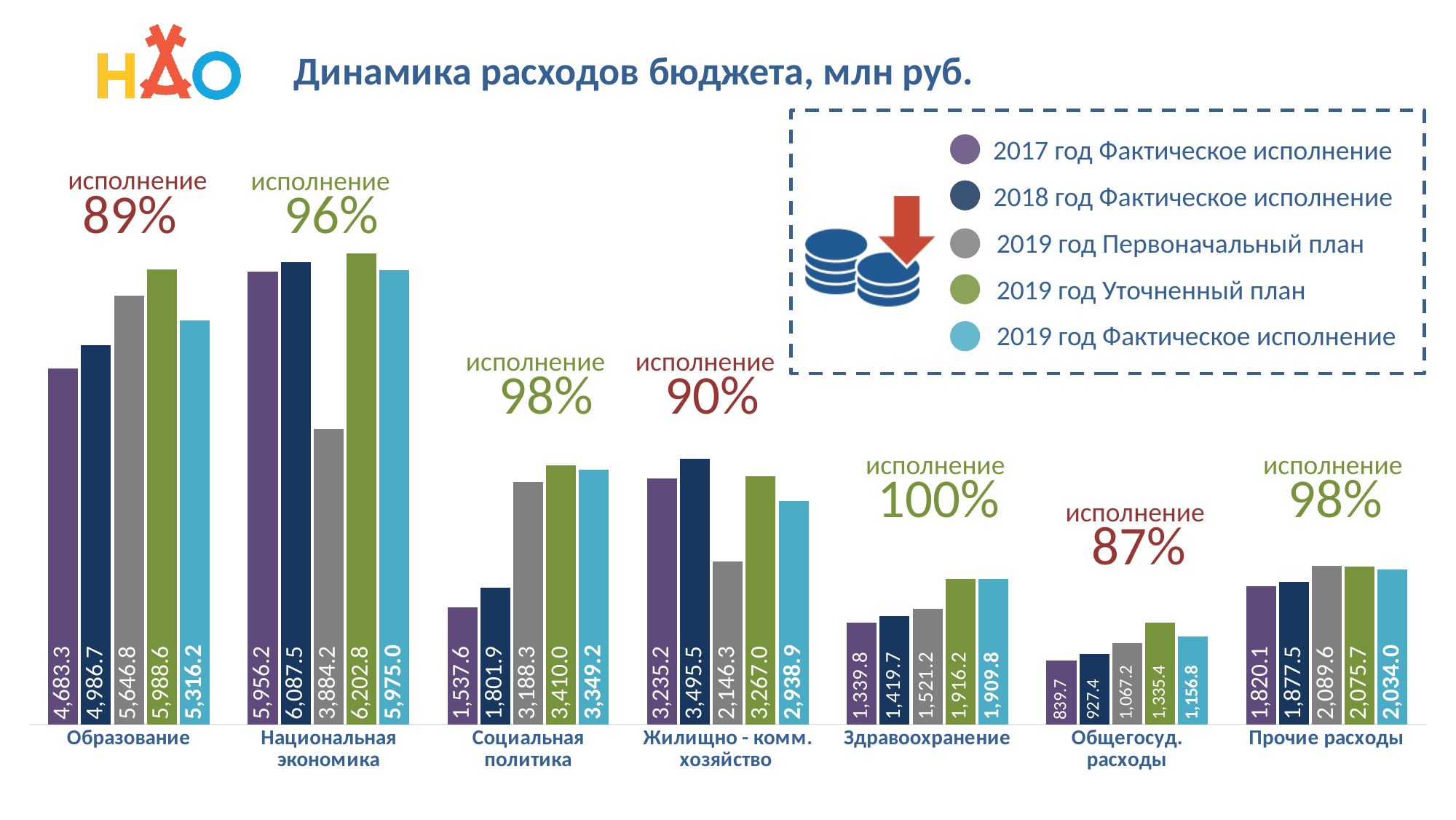
How many categories are shown on the x axis? 7 What is the title of the chart? Динамика расходов бюджета, млн руб. What kind of chart is shown on the slide? Bar chart What is the 2017 год Фактическое исполнение value for Национальная экономика? 5,956.2 What is the difference between the 2019 год Уточненный план and 2019 год Фактическое исполнение values for Образование? 672.4 Which category has the highest 2019 год Уточненный план value? Национальная экономика Which is larger for Жилищно - комм. хозяйство: the 2018 год Фактическое исполнение value or the 2019 год Фактическое исполнение value? 2018 год Фактическое исполнение What is the 2019 год Фактическое исполнение value for Образование? 5,316.2 Which category has the lowest 2017 год Фактическое исполнение value? Общегосуд. расходы How many series does the legend list? 5 What execution percentage (исполнение) is shown above Общегосуд. расходы? 87% What is the 2019 год Уточненный план value for Здравоохранение? 1,916.2